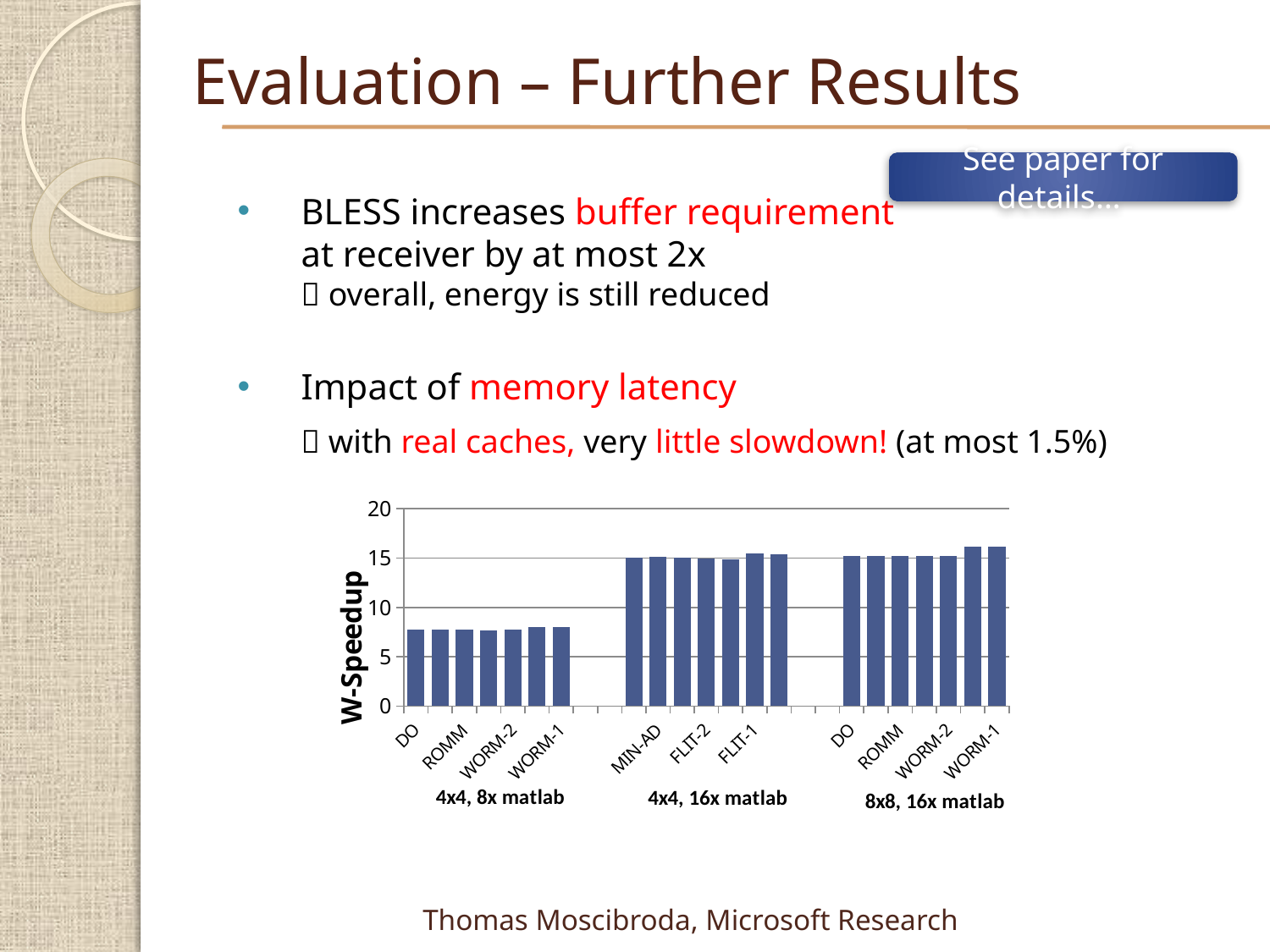
What is the highest tick value shown on the y axis of the chart? 20 Which has the larger W-Speedup: DO in the "4x4, 8x matlab" group or DO in the "8x8, 16x matlab" group? DO in the 8x8, 16x matlab group How many configuration groups are shown along the x axis of the chart? 3 Is the W-Speedup value for DO in the "4x4, 8x matlab" group greater or less than 10? less Is the W-Speedup value for WORM-1 in the "8x8, 16x matlab" group greater or less than 10? greater Is the W-Speedup value for WORM-1 in the "4x4, 8x matlab" group greater or less than 5? greater What kind of chart is shown on the slide? bar chart How many bars are in the "4x4, 8x matlab" group of the chart? 7 Which group of bars has the lowest W-Speedup values in the chart? 4x4, 8x matlab What is the label on the y axis of the chart? W-Speedup